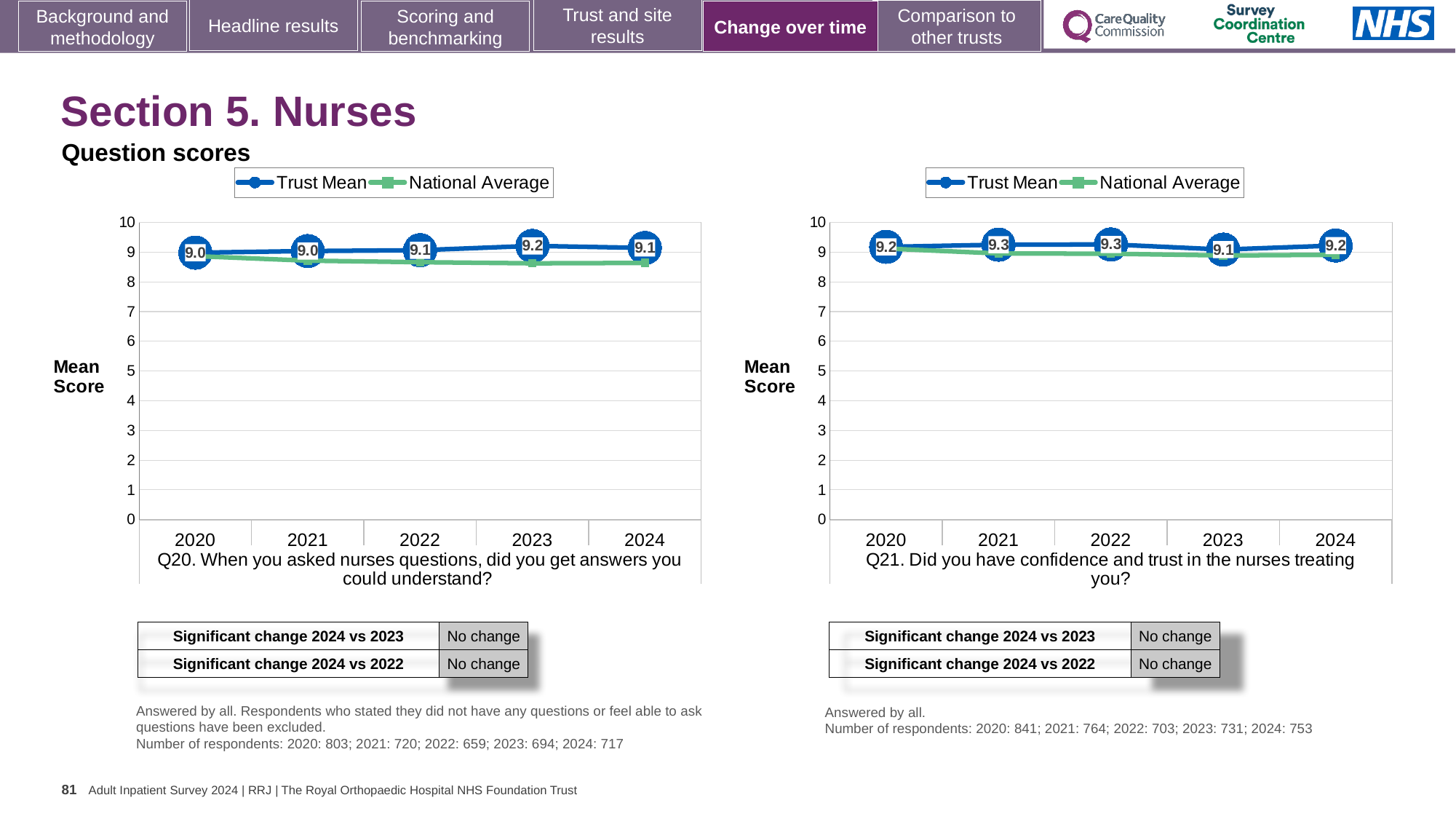
In the Q20 chart on the left, what is the Trust Mean value for 2023? 9.2 In the Q20 chart on the left, is the Trust Mean for 2023 larger or smaller than the Trust Mean for 2020? larger In the Q21 chart on the right, what is the Trust Mean value for 2024? 9.2 In the Q21 chart on the right, what is the difference between the Trust Mean for 2022 and for 2023? 0.2 In the Q20 chart on the left, what is the Trust Mean value for 2020? 9.0 In the Q21 chart on the right, what is the Trust Mean value for 2020? 9.2 In the Q20 chart on the left, which year has the highest Trust Mean? 2023 In the Q21 chart on the right, which year has the lowest Trust Mean? 2023 In the Q20 chart on the left, is the National Average value for 2024 greater or less than 8? greater How many years are shown on the x axis of the Q21 chart on the right? 5 What type of chart is the Q21 chart on the right? Line chart How many series does the legend of the Q20 chart on the left list? 2